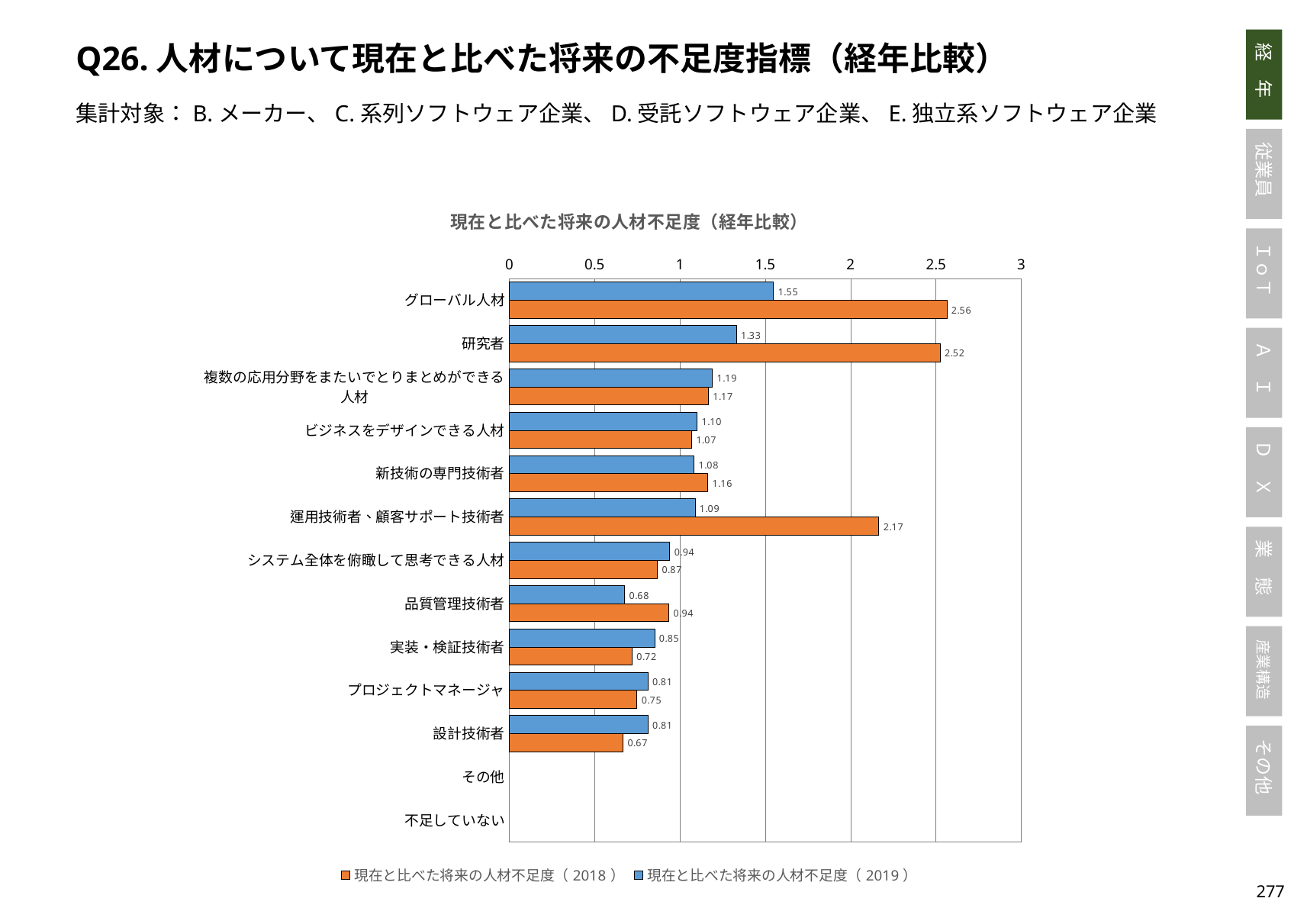
What kind of chart is shown on the slide? Bar chart What is the value for 研究者 in the 2018 series (現在と比べた将来の人材不足度（2018）)? 2.52 What is the value for グローバル人材 in the 2019 series (現在と比べた将来の人材不足度（2019）)? 1.55 Is the 2018 value for 研究者 greater or less than 2? greater How many categories are listed on the vertical axis of the chart? 13 For 新技術の専門技術者, which series has the larger value, 2018 or 2019? 2018 How many series does the legend list? 2 Which category has the highest value in the 2018 series? グローバル人材 What is the 2018 value for 運用技術者、顧客サポート技術者? 2.17 Among the categories with plotted bars, which has the lowest value in the 2018 series? 設計技術者 What is the difference between the 2018 and 2019 values for グローバル人材? 1.01 What is the 2019 value for 品質管理技術者? 0.68